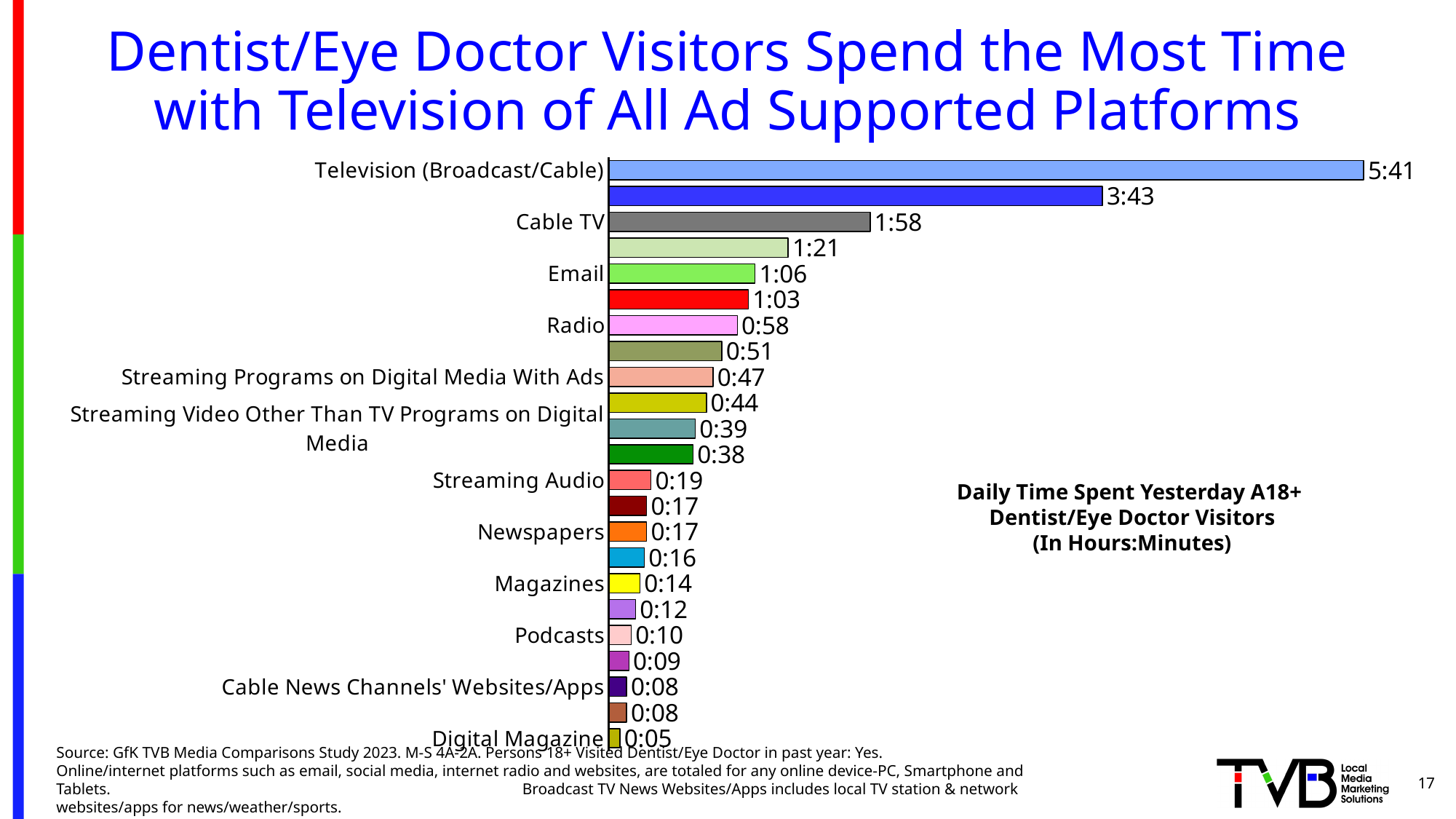
What is the daily time spent with Television (Broadcast/Cable) by Dentist/Eye Doctor visitors? 5:41 What is the value shown for Cable TV? 1:58 Which has a larger value, Newspapers or Magazines? Newspapers What unit does the chart's label say the values are in? Hours:Minutes What is the value shown for Radio? 0:58 How much more time is spent with Television (Broadcast/Cable) than with Cable TV? 3:43 What is the difference between the Email value and the Radio value? 0:08 Which labeled platform has the lowest daily time spent? Digital Magazine What is the value shown for Podcasts? 0:10 Which platform has the highest daily time spent? Television (Broadcast/Cable) What kind of chart is shown on the slide? Bar chart What is the value shown for Streaming Programs on Digital Media With Ads? 0:47